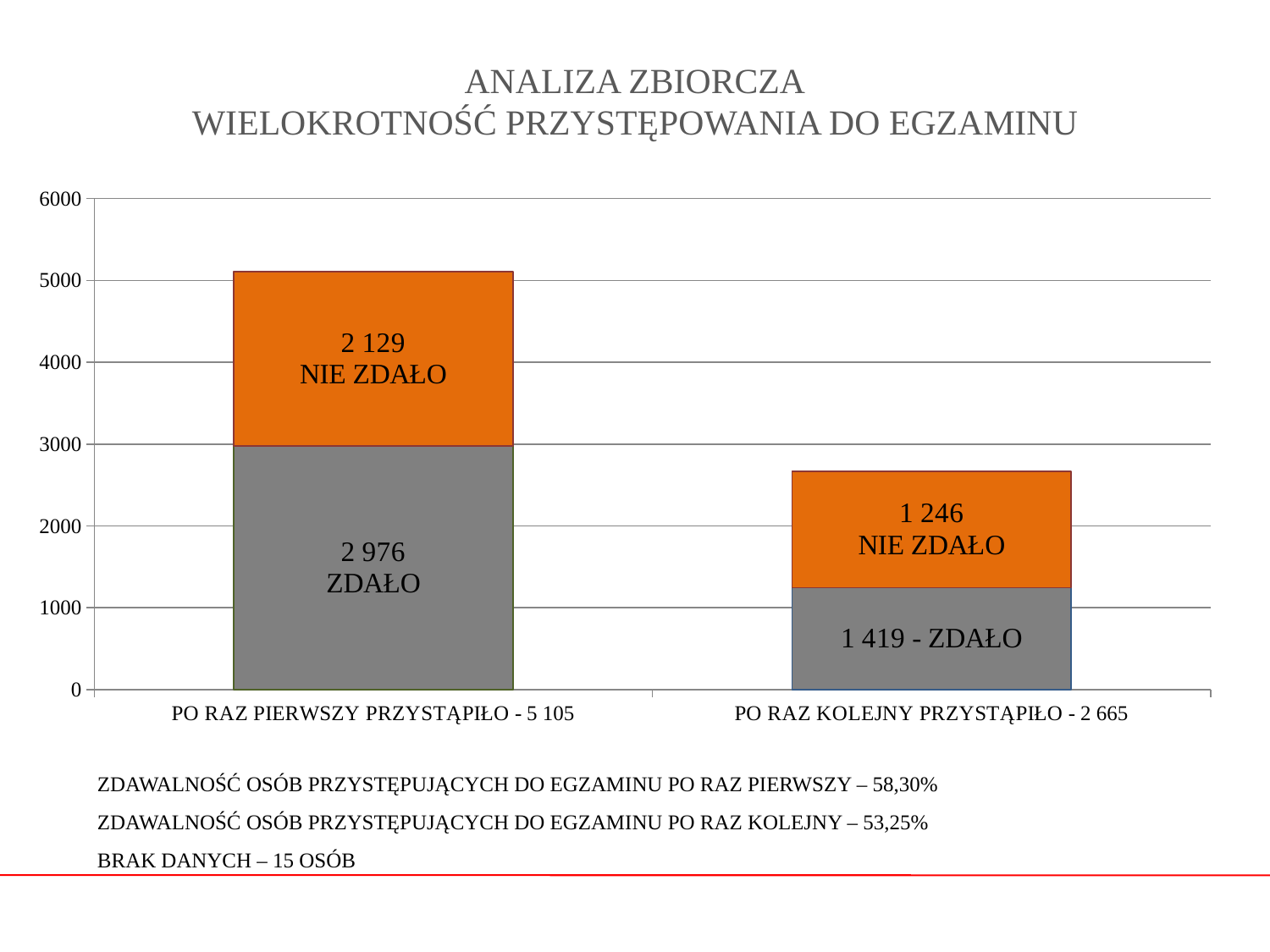
How many people passed (ZDAŁO) among those taking the exam again (PO RAZ KOLEJNY PRZYSTĄPIŁO)? 1 419 What is the difference between the number who passed (ZDAŁO) and the number who did not pass (NIE ZDAŁO) among first-time takers (PO RAZ PIERWSZY PRZYSTĄPIŁO)? 847 Which category has the taller stacked bar, PO RAZ PIERWSZY PRZYSTĄPIŁO or PO RAZ KOLEJNY PRZYSTĄPIŁO? PO RAZ PIERWSZY PRZYSTĄPIŁO Which colour represents the NIE ZDAŁO (did not pass) segment in the chart? orange How many people did not pass (NIE ZDAŁO) among those taking the exam for the first time (PO RAZ PIERWSZY PRZYSTĄPIŁO)? 2 129 How many people passed (ZDAŁO) among those taking the exam for the first time (PO RAZ PIERWSZY PRZYSTĄPIŁO)? 2 976 What is the total of the stacked bar for PO RAZ KOLEJNY PRZYSTĄPIŁO? 2 665 What kind of chart is shown on the slide? stacked bar chart What is the total of the stacked bar for PO RAZ PIERWSZY PRZYSTĄPIŁO? 5 105 How many categories are shown on the x axis of the chart? 2 How many people did not pass (NIE ZDAŁO) among those taking the exam again (PO RAZ KOLEJNY PRZYSTĄPIŁO)? 1 246 Which is larger for PO RAZ KOLEJNY PRZYSTĄPIŁO: the number who passed (ZDAŁO) or the number who did not pass (NIE ZDAŁO)? ZDAŁO